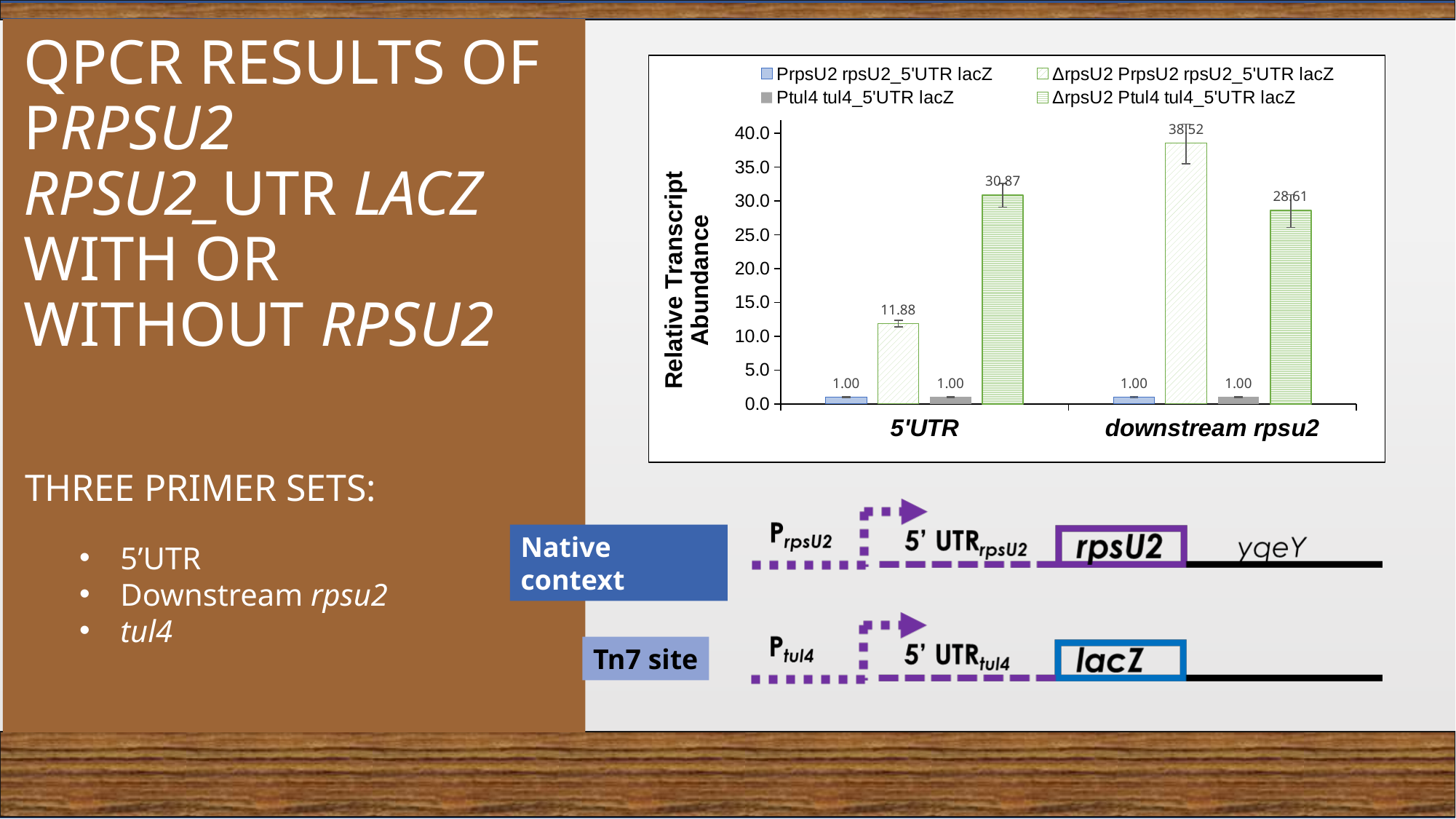
What is the value of the PrpsU2 rpsU2_5'UTR lacZ series for the 5'UTR category? 1.00 What is the value of the ΔrpsU2 PrpsU2 rpsU2_5'UTR lacZ series for the 5'UTR category? 11.88 What is the difference between the ΔrpsU2 Ptul4 tul4_5'UTR lacZ value and the ΔrpsU2 PrpsU2 rpsU2_5'UTR lacZ value in the 5'UTR category? 18.99 What is the difference between the ΔrpsU2 PrpsU2 rpsU2_5'UTR lacZ value and the ΔrpsU2 Ptul4 tul4_5'UTR lacZ value in the downstream rpsu2 category? 9.91 Which series has the highest value in the downstream rpsu2 category? ΔrpsU2 PrpsU2 rpsU2_5'UTR lacZ What is the value of the ΔrpsU2 Ptul4 tul4_5'UTR lacZ series for the 5'UTR category? 30.87 What is the value of the ΔrpsU2 PrpsU2 rpsU2_5'UTR lacZ series for the downstream rpsu2 category? 38.52 What is the label of the y axis of the chart? Relative Transcript Abundance What is the value of the ΔrpsU2 Ptul4 tul4_5'UTR lacZ series for the downstream rpsu2 category? 28.61 How many series does the chart legend list? 4 How many categories are shown on the x axis of the chart? 2 Which is larger: the ΔrpsU2 PrpsU2 rpsU2_5'UTR lacZ value for 5'UTR or for downstream rpsu2? downstream rpsu2